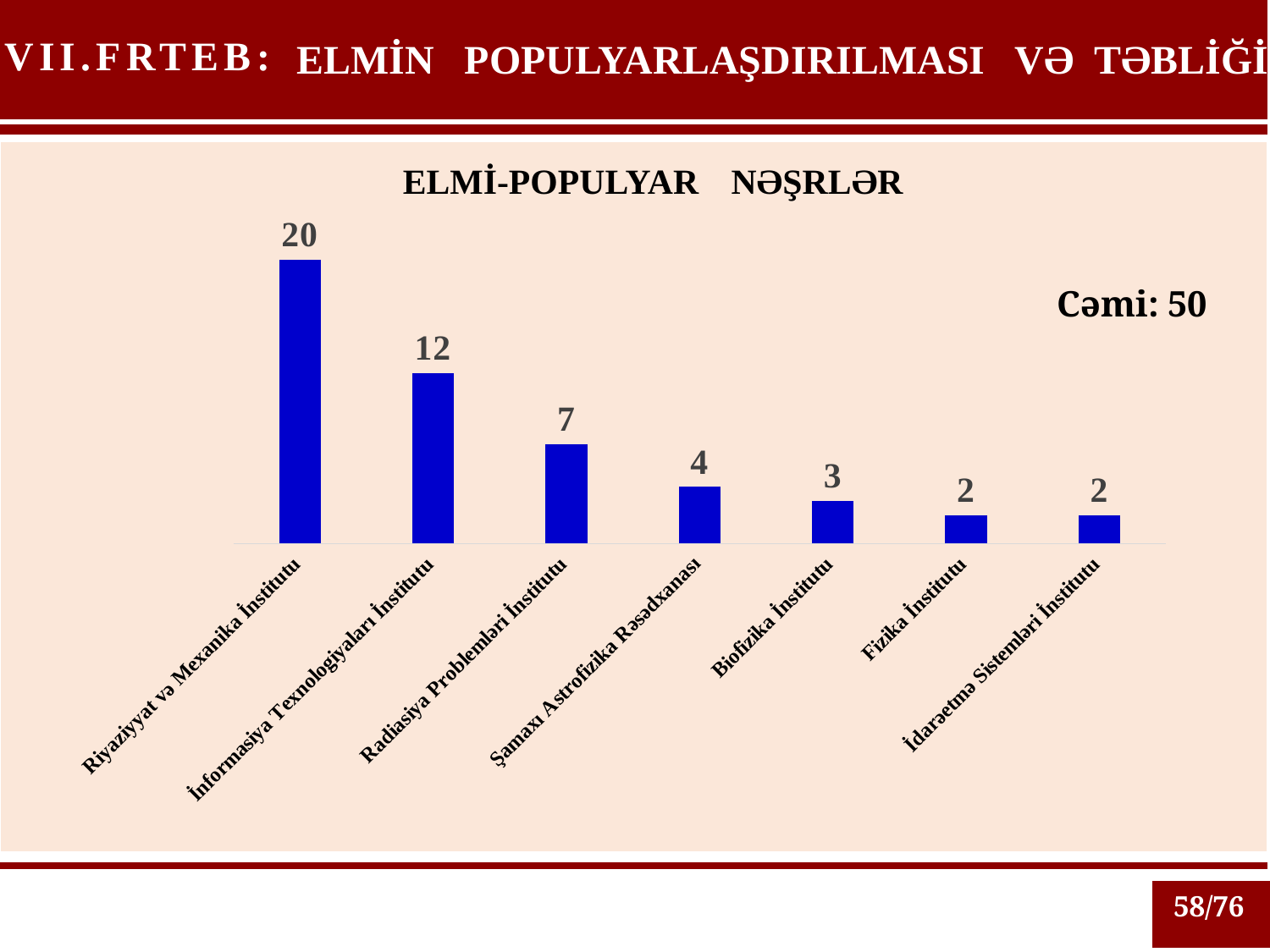
What is the value for Biofizika İnstitutu? 3 What is the value for Şamaxı Astrofizika Rəsədxanası? 4 Which is larger, the value for Radiasiya Problemləri İnstitutu or the value for Şamaxı Astrofizika Rəsədxanası? Radiasiya Problemləri İnstitutu What is the value for Riyaziyyat və Mexanika İnstitutu? 20 What is the value for İnformasiya Texnologiyaları İnstitutu? 12 Which category has the highest value? Riyaziyyat və Mexanika İnstitutu What is the title of the chart? ELMİ-POPULYAR NƏŞRLƏR What kind of chart is shown on the slide? Bar chart How many categories are shown in the chart? 7 What is the value for Radiasiya Problemləri İnstitutu? 7 Do the values rise or fall from left to right along the x axis? Fall What is the difference between the values for Riyaziyyat və Mexanika İnstitutu and İnformasiya Texnologiyaları İnstitutu? 8